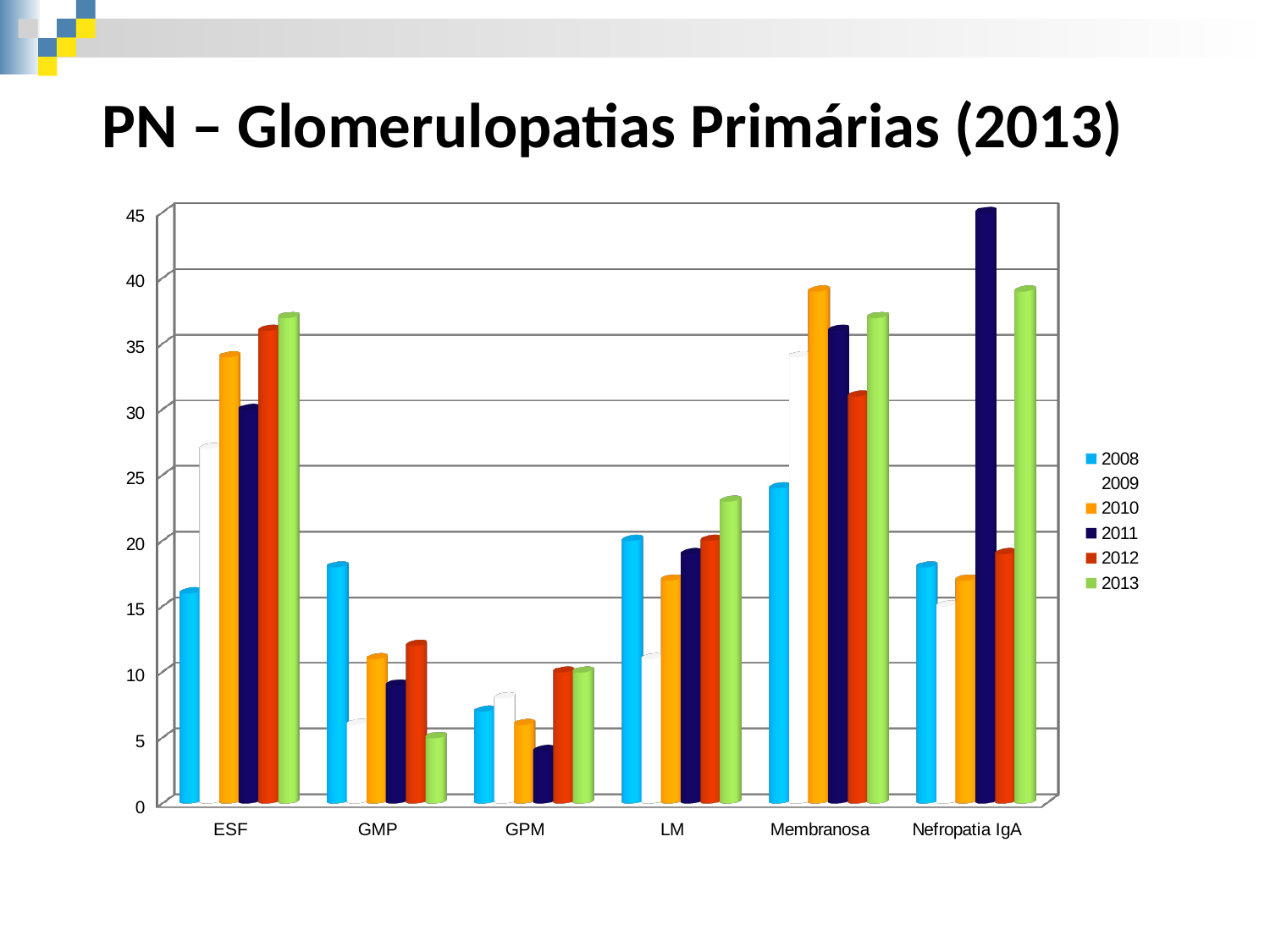
Which category has the tallest bar for the 2010 series? Membranosa Is the 2008 value for GMP greater or less than 15? greater Which category has the lowest bar for the 2013 series? GMP How many series does the chart's legend list? 6 For Nefropatia IgA, which is larger: the 2011 value or the 2013 value? 2011 What kind of chart is shown on the slide? Bar chart Which category has the tallest bar for the 2011 series? Nefropatia IgA How many categories are shown on the x axis of the chart? 6 Is the 2013 value for ESF greater or less than 35? greater Is the 2013 value for GMP greater or less than 10? less For Membranosa, which is larger: the 2010 value or the 2008 value? 2010